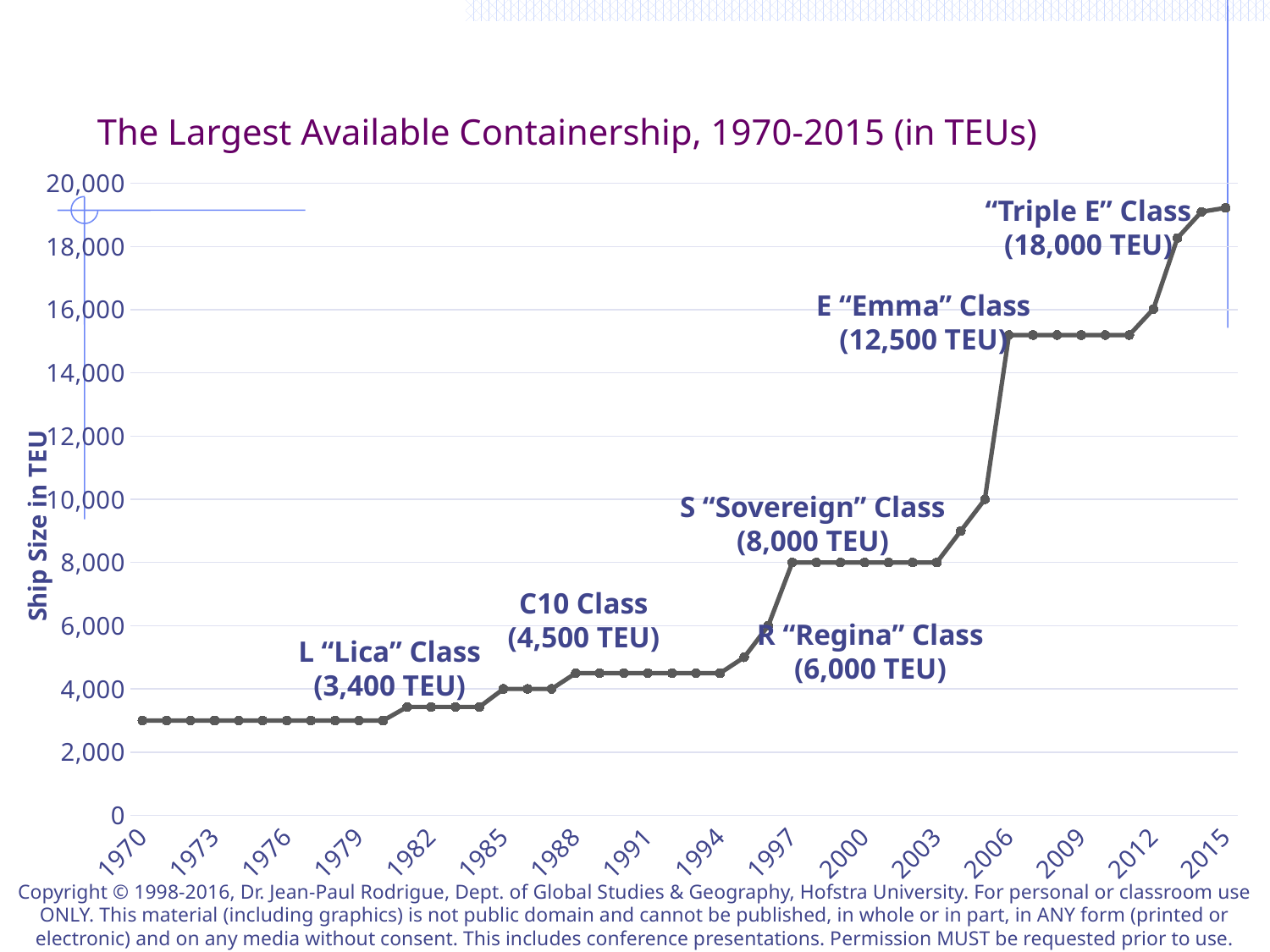
According to the annotation, what capacity is listed for the "Triple E" Class? 18,000 TEU What is the label of the vertical axis? Ship Size in TEU According to the annotation, what capacity is listed for the S "Sovereign" Class? 8,000 TEU What is the title of the chart? The Largest Available Containership, 1970-2015 (in TEUs) Which year has the highest ship size value on the chart? 2015 Is the value for 1970 greater or less than 4,000? less How many ship classes are annotated on the chart? 6 Is the value for 2000 greater or less than 10,000? less Is the value for 2015 greater or less than 18,000? greater Do the values generally rise or fall from 1970 to 2015? rise What kind of chart is shown on the slide? line chart